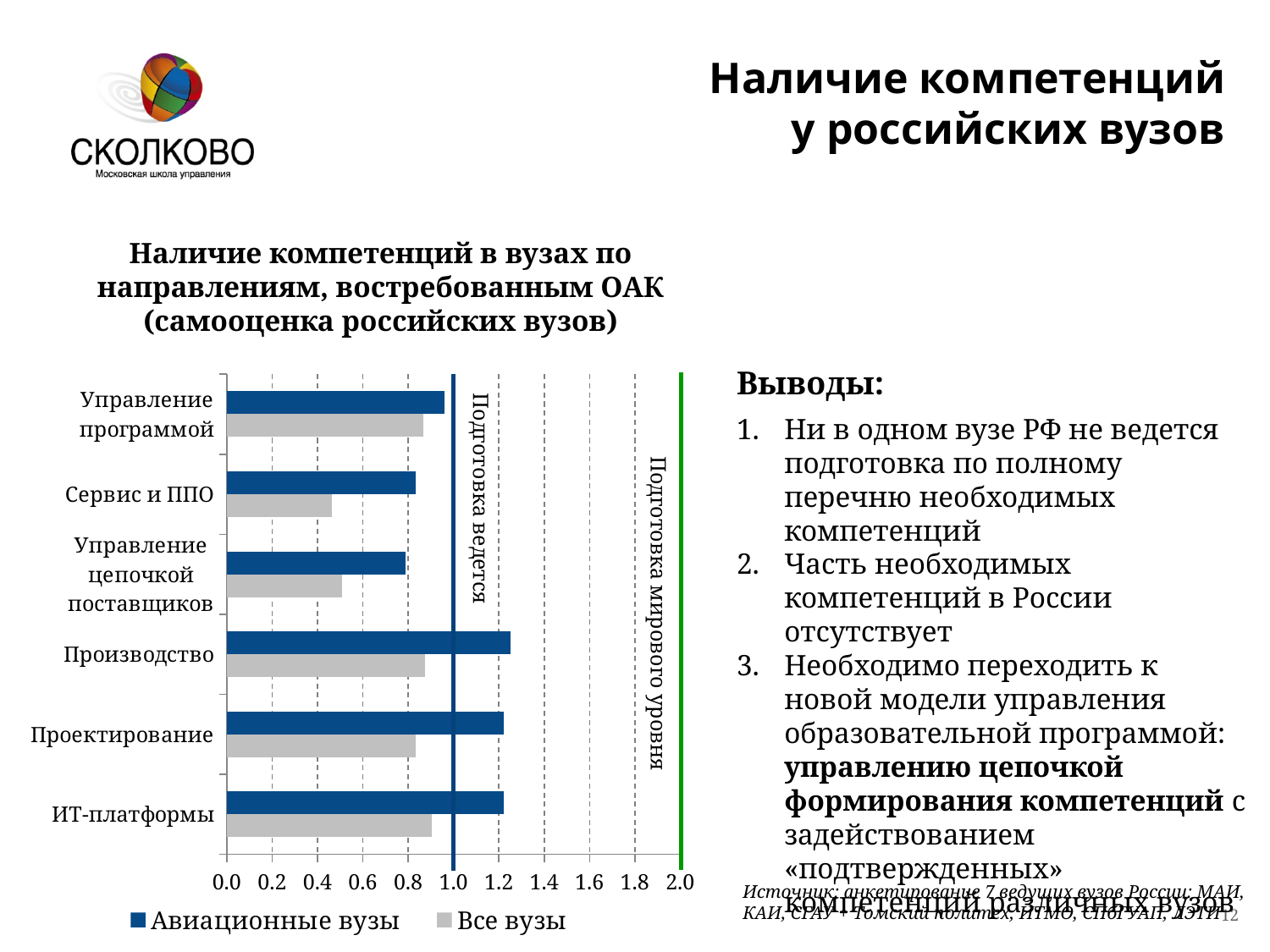
Is the value for Управление цепочкой поставщиков in the Все вузы series greater or less than 0.6? less How many categories (directions) are plotted on the chart? 6 Is the value for Управление программой in the Авиационные вузы series greater or less than 1.0? less What label is attached to the green vertical line at 2.0 on the chart? Подготовка мирового уровня Is the value for Сервис и ППО in the Все вузы series greater or less than 0.6? less How many series does the chart legend list? 2 What kind of chart is shown on the slide? bar chart What label is attached to the vertical line at 1.0 on the chart? Подготовка ведется For Производство, which series has the larger value: Авиационные вузы or Все вузы? Авиационные вузы For Сервис и ППО, which series has the larger value: Авиационные вузы or Все вузы? Авиационные вузы